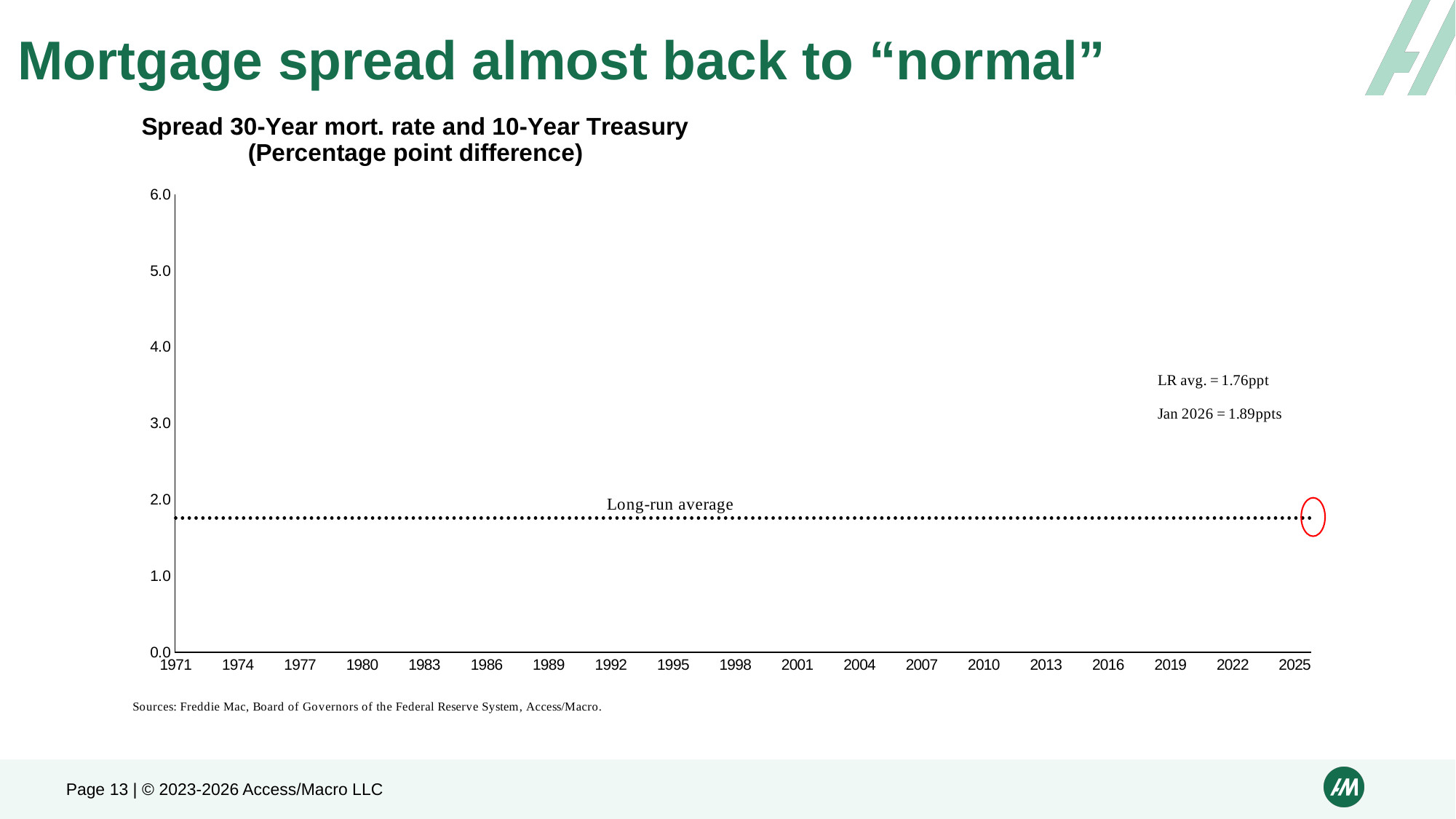
What label is written above the dotted horizontal line? Long-run average Is the long-run average line greater or less than 2.0 on the y axis? less What kind of chart is shown on the slide? line chart What is the title of the chart? Spread 30-Year mort. rate and 10-Year Treasury (Percentage point difference) What is the highest value shown on the y axis? 6.0 By how many percentage points does the Jan 2026 spread exceed the long-run average? 0.13 What is the long-run average spread shown on the chart? 1.76ppt Which is larger, the Jan 2026 spread or the long-run average? Jan 2026 spread What is the first year shown on the x axis? 1971 Is the long-run average line greater or less than 1.0 on the y axis? greater What is the spread value for Jan 2026 shown on the chart? 1.89ppts What is the last year shown on the x axis? 2025